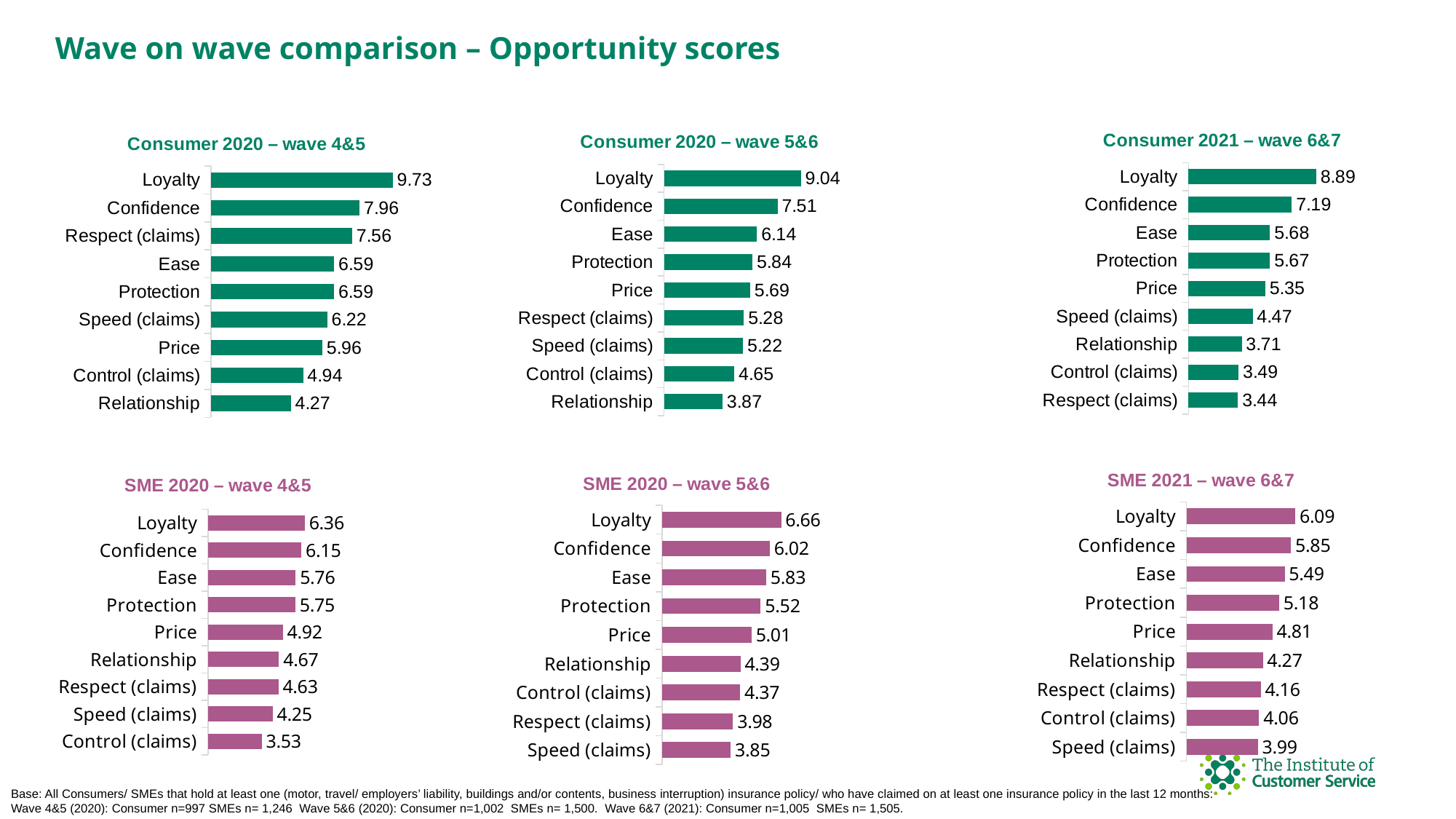
In the 'SME 2020 – wave 4&5' chart, which is larger, Ease or Price? Ease In the 'SME 2021 – wave 6&7' chart, which category has the highest value? Loyalty In the 'SME 2020 – wave 5&6' chart, what is the value for Price? 5.01 What type of chart is the 'SME 2020 – wave 5&6' chart? Bar chart In the 'SME 2021 – wave 6&7' chart, what is the difference between Loyalty and Speed (claims)? 2.10 In the 'Consumer 2020 – wave 4&5' chart, what is the value for Loyalty? 9.73 In the 'Consumer 2021 – wave 6&7' chart, which category has the lowest value? Respect (claims) In the 'Consumer 2020 – wave 4&5' chart, what is the value for Relationship? 4.27 How many charts are shown on the slide? 6 In the 'Consumer 2020 – wave 5&6' chart, what is the difference between Loyalty and Confidence? 1.53 How many categories are shown in the 'Consumer 2021 – wave 6&7' chart? 9 What colour are the bars in the SME charts? Purple